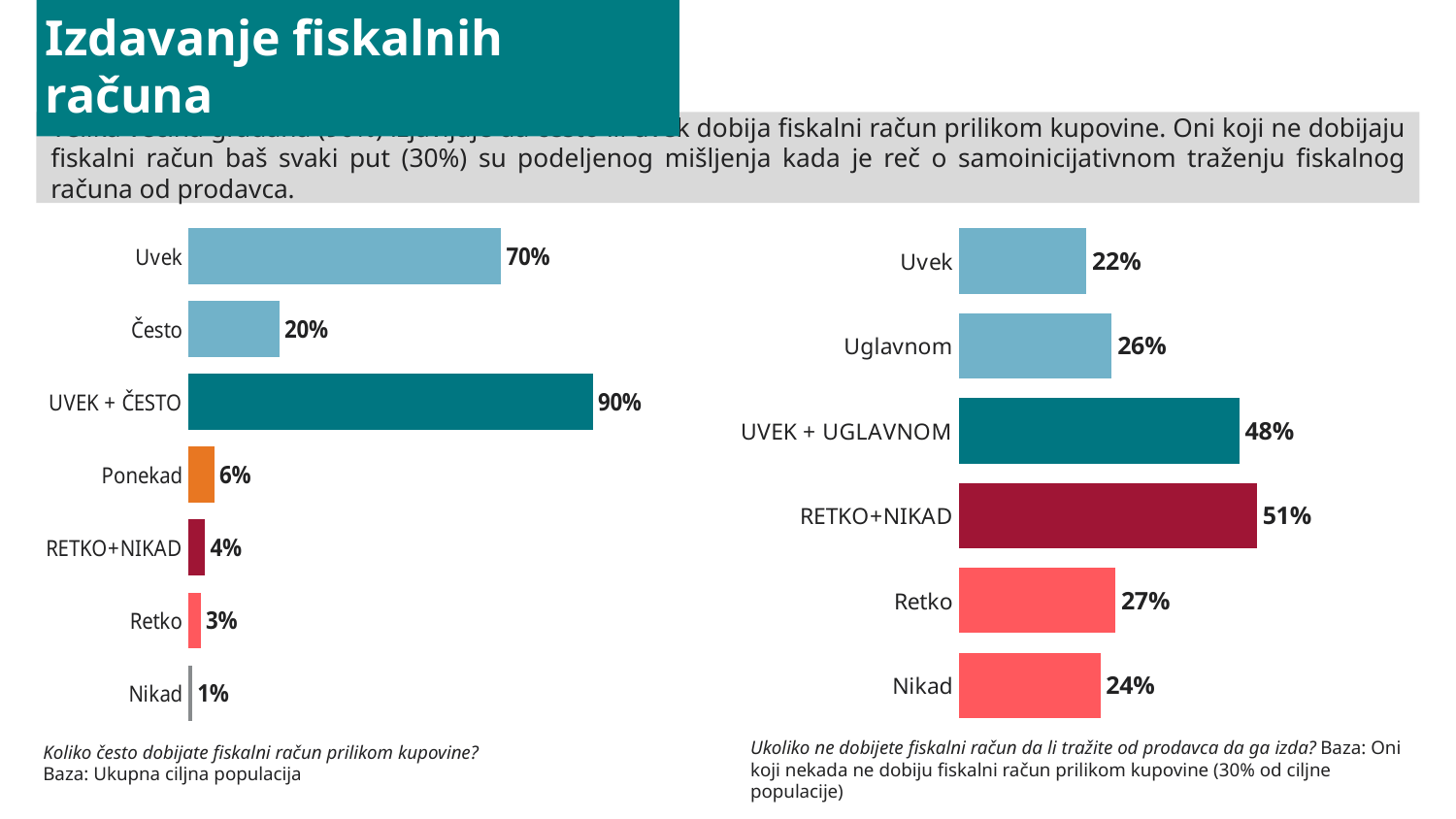
In the right chart, which is larger, UVEK + UGLAVNOM or RETKO+NIKAD? RETKO+NIKAD In the left chart, which category has the lowest value? Nikad In the left chart, what is the difference between Uvek and Često? 50% In the right chart, which category has the lowest value? Uvek In the right chart, what is the difference between Retko and Nikad? 3% In the left chart, what is the value for Ponekad? 6% What type of chart is the left chart? Bar chart In the left chart, which category has the highest value? UVEK + ČESTO In the right chart, what is the value for Uglavnom? 26% In the right chart, what is the value for RETKO+NIKAD? 51% How many categories are shown in the right chart? 6 In the left chart, what is the value for Uvek? 70%